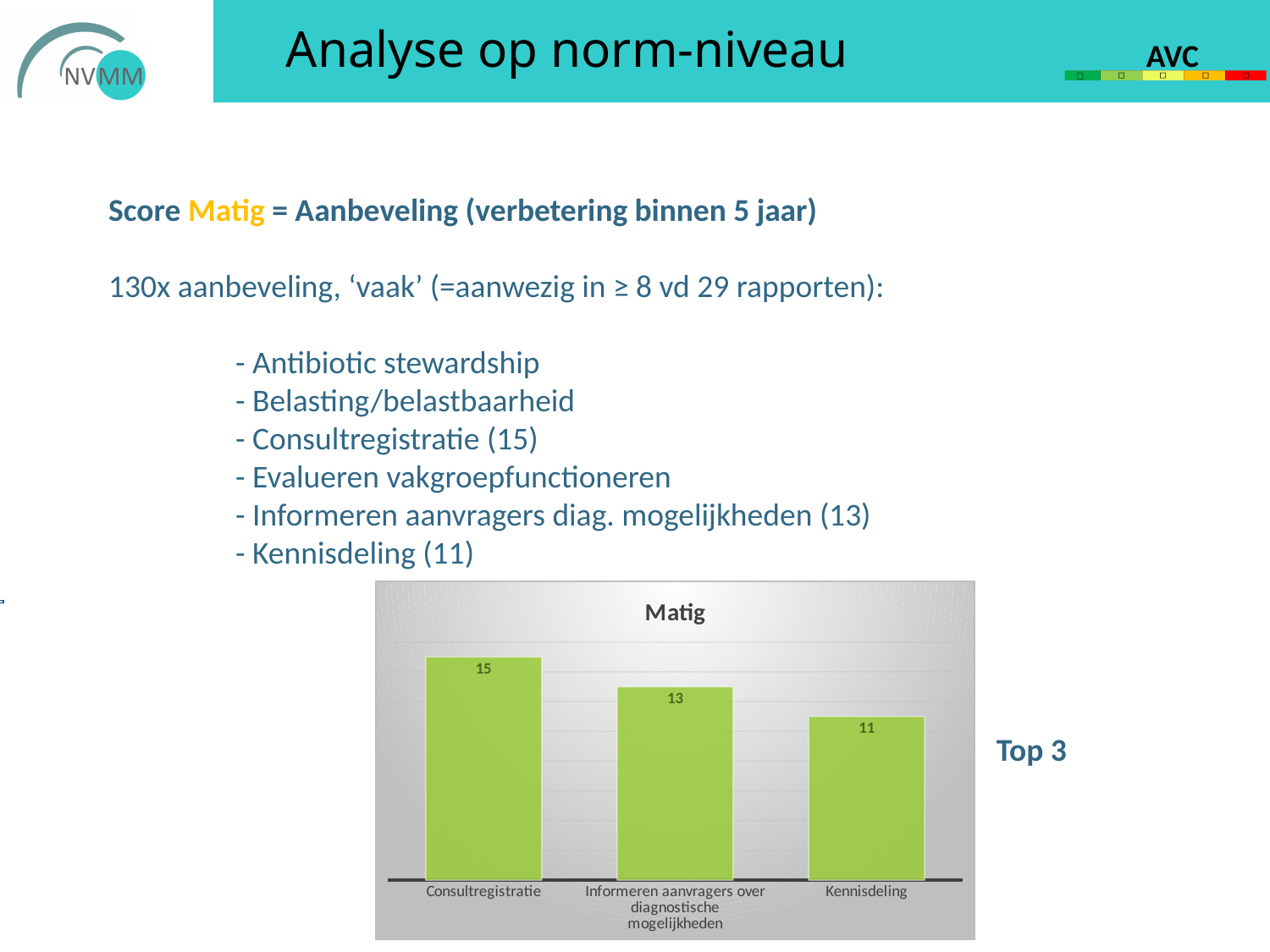
How many categories are shown in the chart? 3 What is the difference between the values for Consultregistratie and Informeren aanvragers over diagnostische mogelijkheden? 2 What is the value for Informeren aanvragers over diagnostische mogelijkheden in the chart? 13 Which is larger: the value for Informeren aanvragers over diagnostische mogelijkheden or the value for Kennisdeling? Informeren aanvragers over diagnostische mogelijkheden What kind of chart is shown on the slide? Bar chart What is the value for Consultregistratie in the chart? 15 Do the values rise or fall from left to right across the chart? Fall What is the title of the chart? Matig What is the value for Kennisdeling in the chart? 11 Which category has the highest value in the chart? Consultregistratie Which category has the lowest value in the chart? Kennisdeling What is the difference between the values for Consultregistratie and Kennisdeling? 4